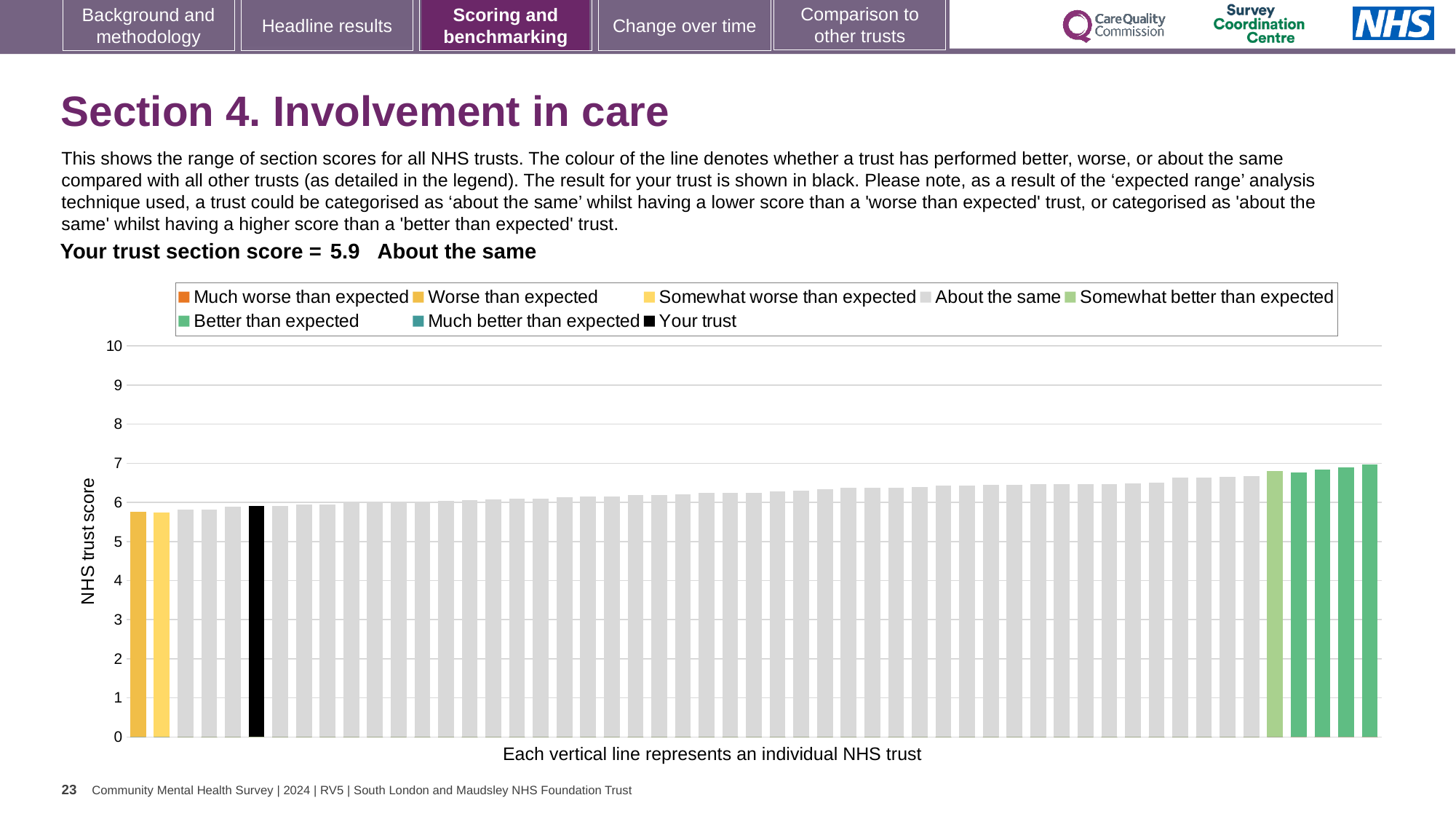
Is the value of the black bar (your trust) greater or less than 7? less Is the value of the highest bar greater or less than 6? greater Which category is your trust's section score placed in? About the same What is the label on the vertical axis of the chart? NHS trust score Is the value of the black bar (your trust) greater or less than 5? greater What is the section score for your trust shown on the slide? 5.9 According to the legend, what colour represents 'Your trust'? black How many entries does the chart legend list? 8 What kind of chart is shown on the slide? bar chart How many bars on the chart are coloured black? 1 Do the bar values rise or fall from left to right along the x axis? rise